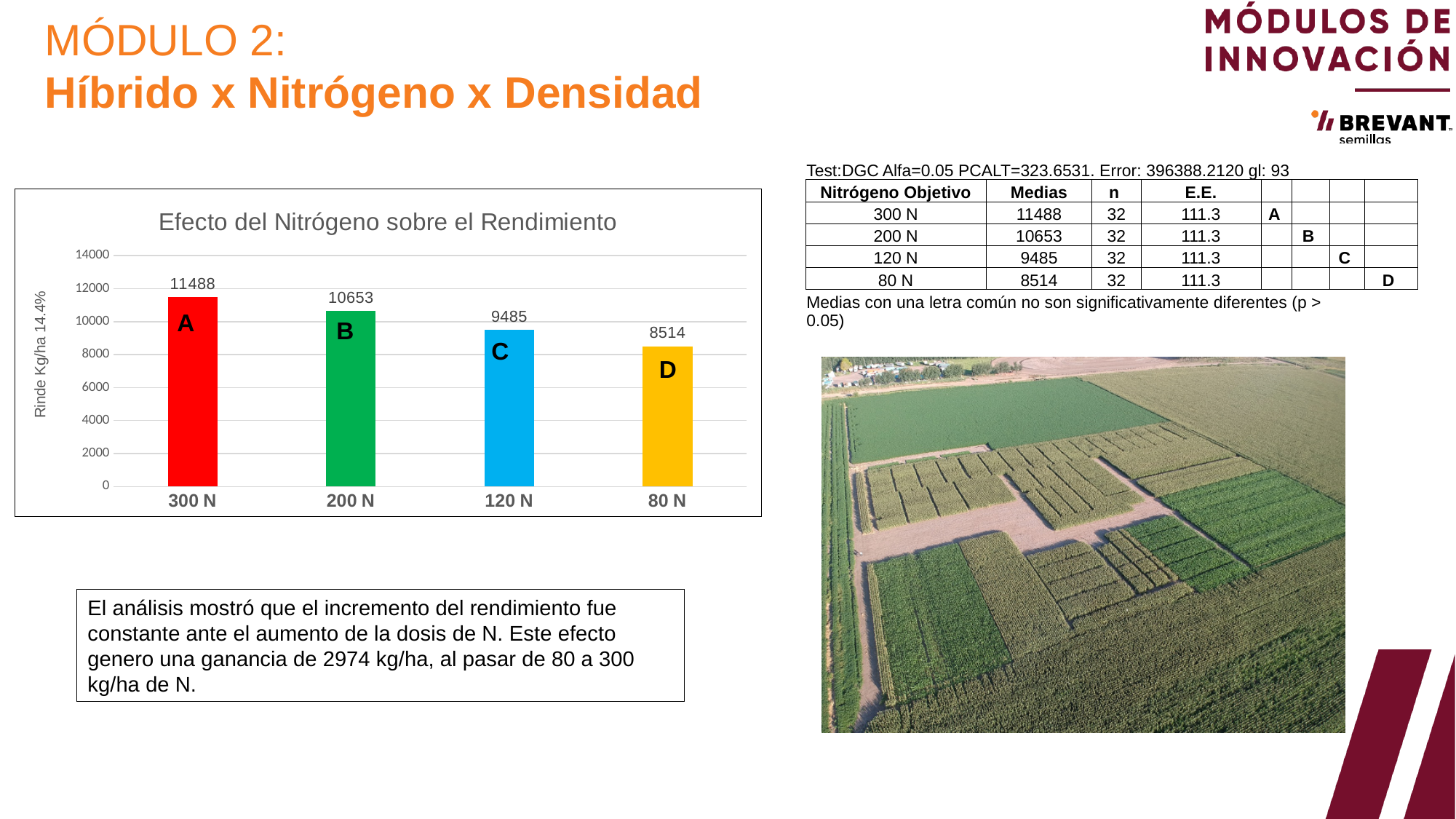
Which category has the highest value in the chart? 300 N What is the value for 300 N in the chart? 11488 How many categories are shown in the chart? 4 What is the difference between the values for 300 N and 80 N? 2974 What is the difference between the values for 200 N and 120 N? 1168 Which category has the lowest value in the chart? 80 N What is the value for 80 N in the chart? 8514 What kind of chart is shown on the slide? Bar chart Do the values rise or fall from left to right along the x axis? Fall What is the title of the chart? Efecto del Nitrógeno sobre el Rendimiento What is the value for 120 N in the chart? 9485 Which is larger, the value for 200 N or the value for 120 N? 200 N